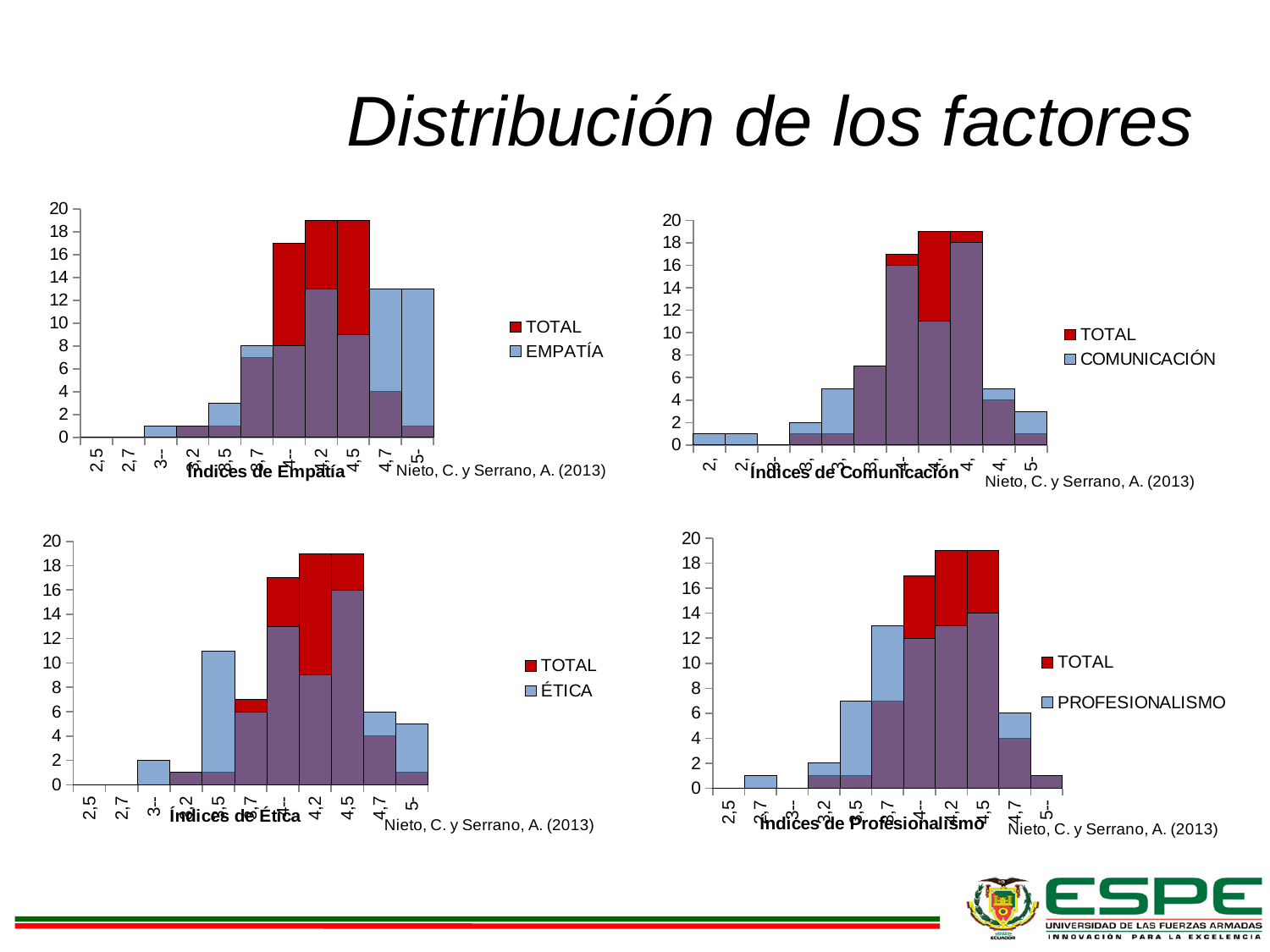
In the 'Índices de Profesionalismo' chart, is the PROFESIONALISMO value for 3,7 greater or less than 10? greater In the 'Índices de Ética' chart, which has the larger ÉTICA value, 3,5 or 3,7? 3,5 In the 'Índices de Empatía' chart, which has the larger EMPATÍA value, 4,5 or 4,7? 4,7 What kind of chart is the 'Índices de Empatía' chart? bar chart How many series does the legend of the 'Índices de Empatía' chart list? 2 What are the two legend entries of the 'Índices de Profesionalismo' chart? TOTAL and PROFESIONALISMO In the 'Índices de Ética' chart, is the ÉTICA value for 3,5 greater or less than 8? greater In the 'Índices de Ética' chart, which category has the highest ÉTICA value? 4,5 In the 'Índices de Empatía' chart, is the EMPATÍA value for 5-- greater or less than 10? greater How many series does the legend of the 'Índices de Comunicación' chart list? 2 What is the title of the slide? Distribución de los factores